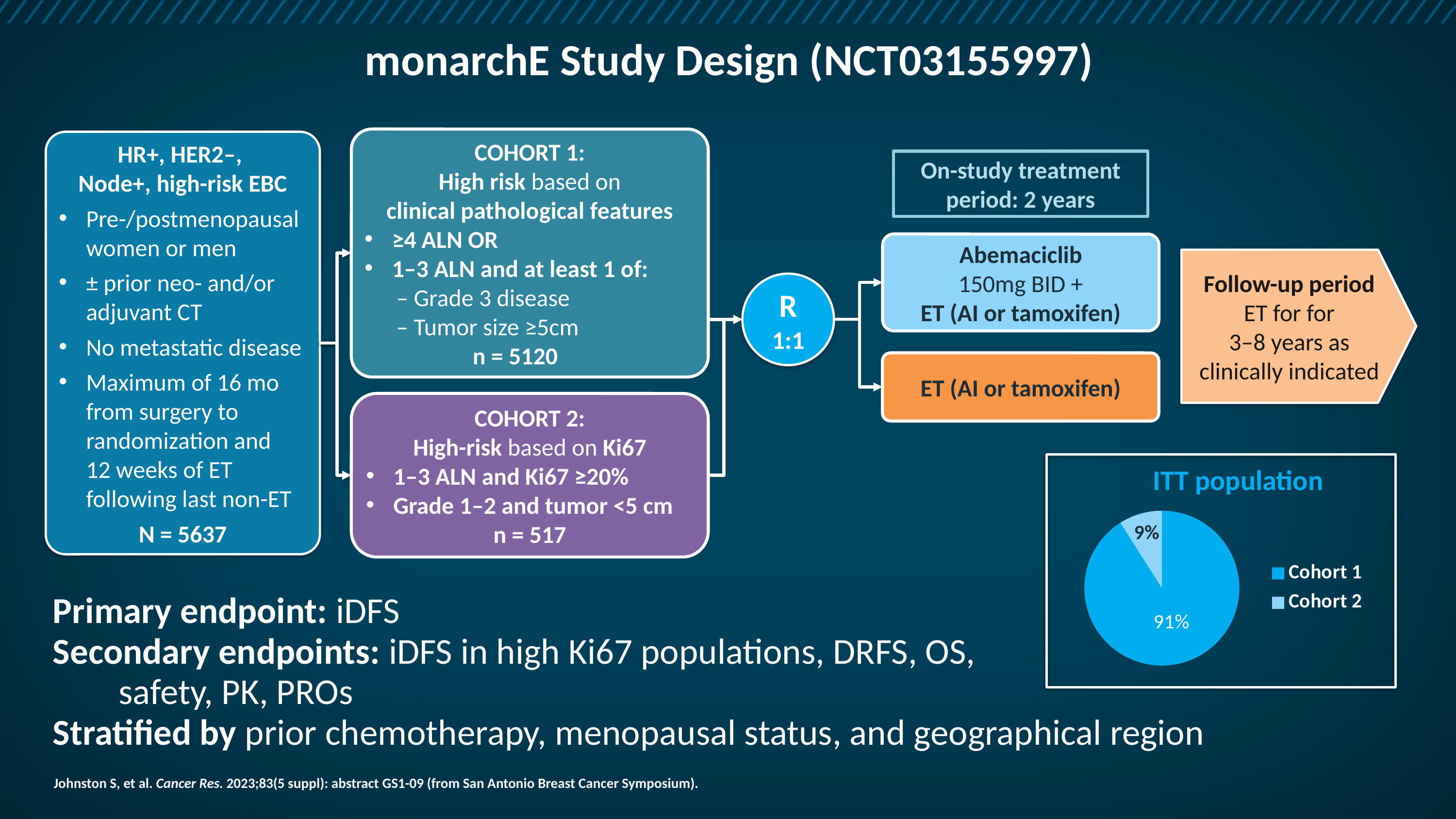
What is the title of the chart on the slide? ITT population What are the two legend entries of the ITT population pie chart? Cohort 1, Cohort 2 What is the difference in percentage points between the Cohort 1 and Cohort 2 slices in the ITT population pie chart? 82 percentage points In the ITT population pie chart, which is larger, Cohort 1 or Cohort 2? Cohort 1 What share of the ITT population pie is Cohort 1? 91% Which cohort has the largest slice in the ITT population pie chart? Cohort 1 What kind of chart is the ITT population chart? pie chart Which cohort has the smallest slice in the ITT population pie chart? Cohort 2 How many slices does the ITT population pie chart have? 2 What share of the ITT population pie is Cohort 2? 9% How many entries does the legend of the ITT population chart list? 2